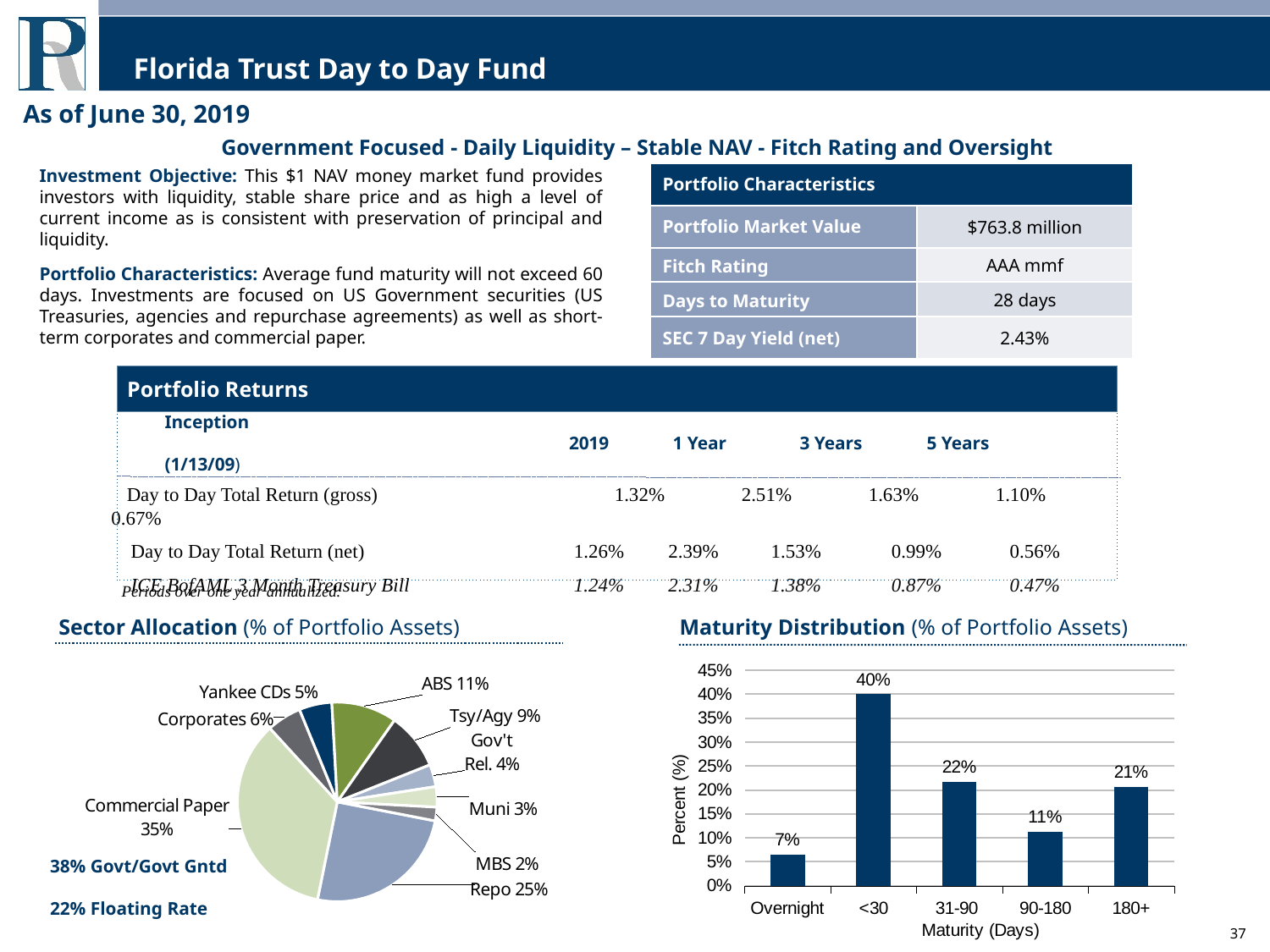
On the Sector Allocation chart, which sector has the smallest share? MBS What kind of chart is the Maturity Distribution chart? Bar chart On the Maturity Distribution chart, which maturity category has the lowest value? Overnight On the Sector Allocation chart, which is larger, ABS or Tsy/Agy? ABS On the Maturity Distribution chart, what is the value for the Overnight category? 7% On the Maturity Distribution chart, which maturity category has the highest value? <30 What kind of chart is the Sector Allocation chart? Pie chart On the Sector Allocation chart, what share of portfolio assets is Repo? 25% On the Maturity Distribution chart, how many maturity categories are shown? 5 On the Maturity Distribution chart, what is the value for the <30 days category? 40% On the Maturity Distribution chart, what is the difference between the 31-90 and 90-180 categories? 11% On the Sector Allocation chart, what share of portfolio assets is Commercial Paper? 35%